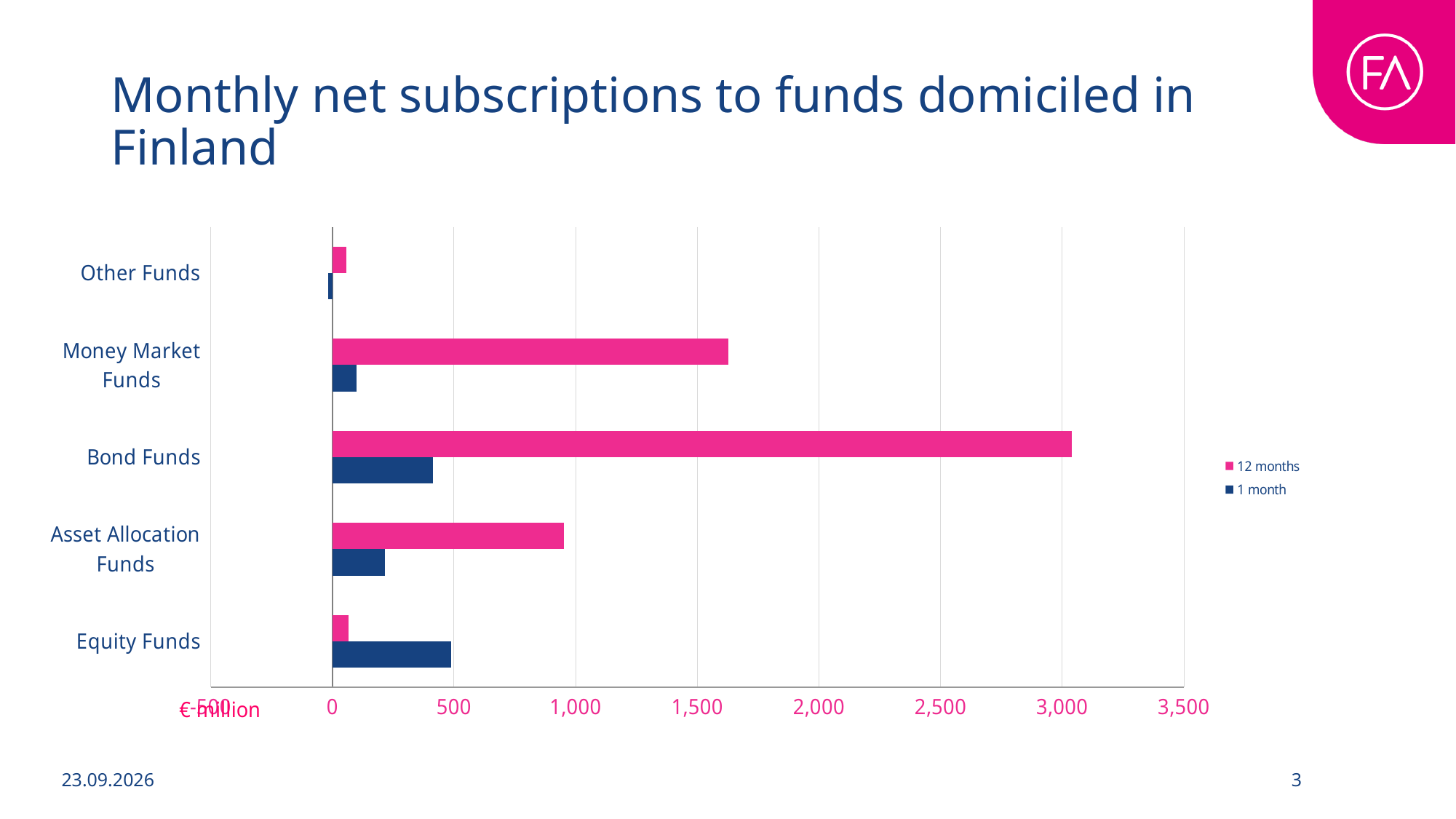
How many series does the legend list? 2 How many fund categories are shown on the chart? 5 Which is larger: the 12 months value for Bond Funds or for Money Market Funds? Bond Funds Is the 12 months value for Asset Allocation Funds greater or less than 1,000? less Which fund category has the highest 1 month value? Equity Funds Which fund category has the highest 12 months value? Bond Funds Is the 12 months value for Bond Funds greater or less than 3,000? greater What are the two series named in the legend? 12 months and 1 month Which fund category has the lowest 1 month value? Other Funds Is the 12 months value for Money Market Funds greater or less than 1,500? greater Which is larger for Equity Funds: the 1 month value or the 12 months value? 1 month What kind of chart is shown on the slide? bar chart